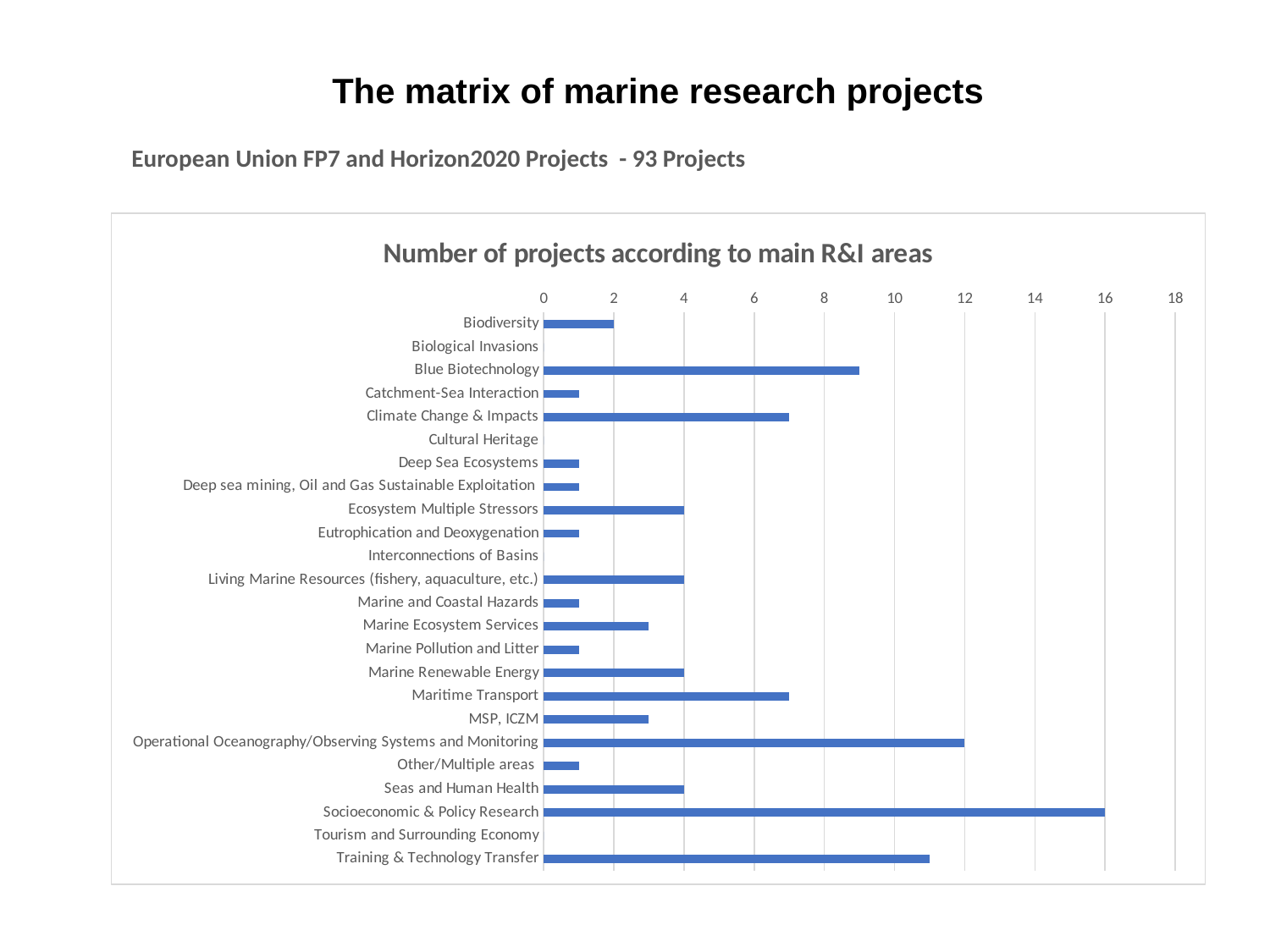
What kind of chart is shown on the slide? bar chart What is the title of the chart? Number of projects according to main R&I areas How many projects are in Socioeconomic & Policy Research? 16 Is the value for Blue Biotechnology greater or less than 8? greater How many projects are in Operational Oceanography/Observing Systems and Monitoring? 12 Which R&I area has the highest number of projects? Socioeconomic & Policy Research Which has more projects, Blue Biotechnology or Climate Change & Impacts? Blue Biotechnology Is the value for Maritime Transport greater or less than 6? greater Is the value for Training & Technology Transfer greater or less than 10? greater What is the difference between the number of projects in Socioeconomic & Policy Research and in Operational Oceanography/Observing Systems and Monitoring? 4 How many R&I areas are listed on the chart? 24 How many projects are in Biodiversity? 2